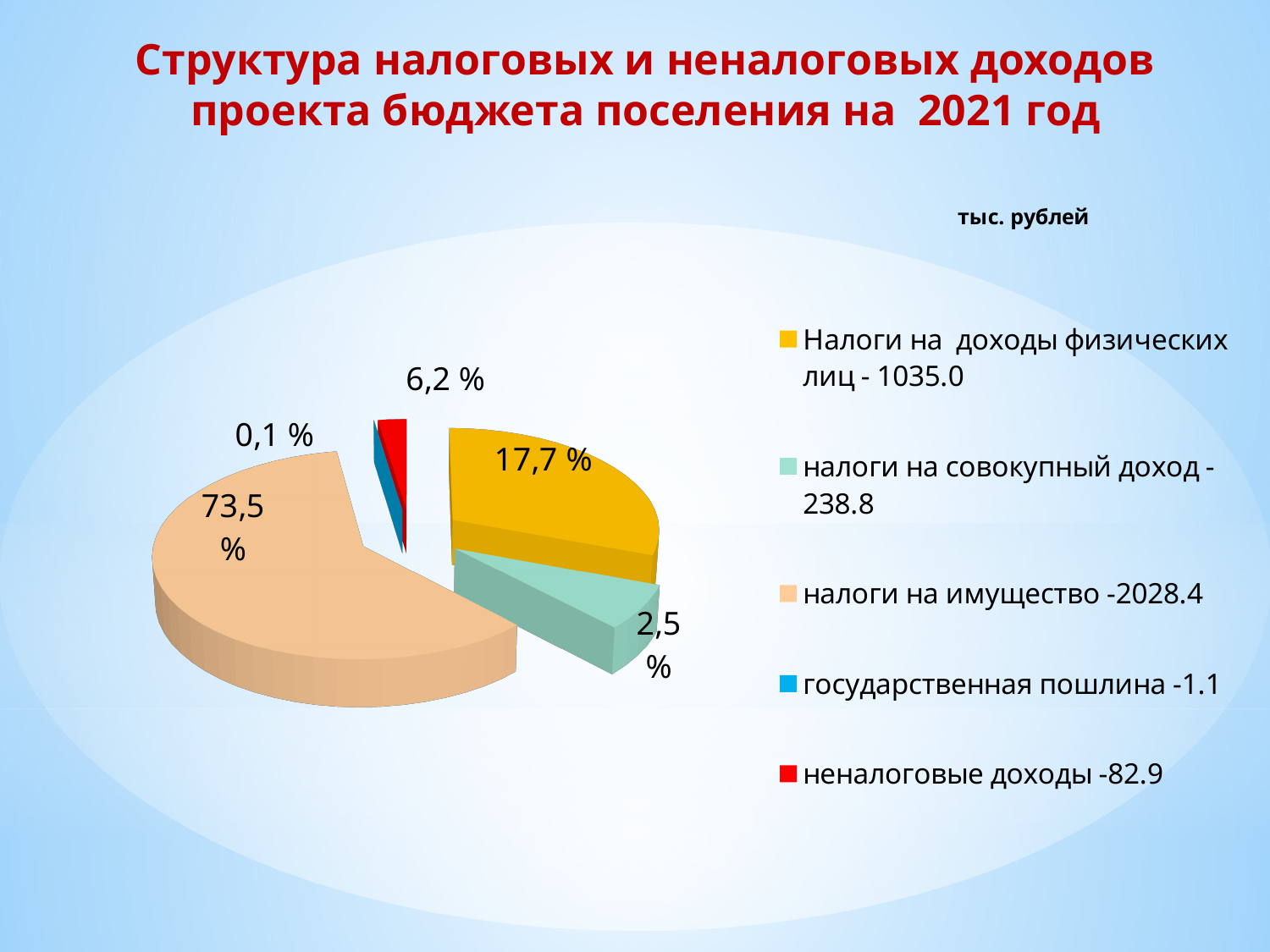
How many entries does the legend list? 5 What kind of chart is shown on the slide? pie chart What share of the pie is labelled for неналоговые доходы? 6,2 % What is the difference in percentage points between the налоги на имущество slice and the Налоги на доходы физических лиц slice? 55,8 % How many slices does the pie chart have? 5 What value in тыс. рублей does the legend give for налоги на совокупный доход? 238.8 Which category has the smallest slice of the pie? государственная пошлина Which category has the largest slice of the pie? налоги на имущество What share of the pie is labelled for государственная пошлина? 0,1 % What share of the pie is labelled for Налоги на доходы физических лиц? 17,7 %